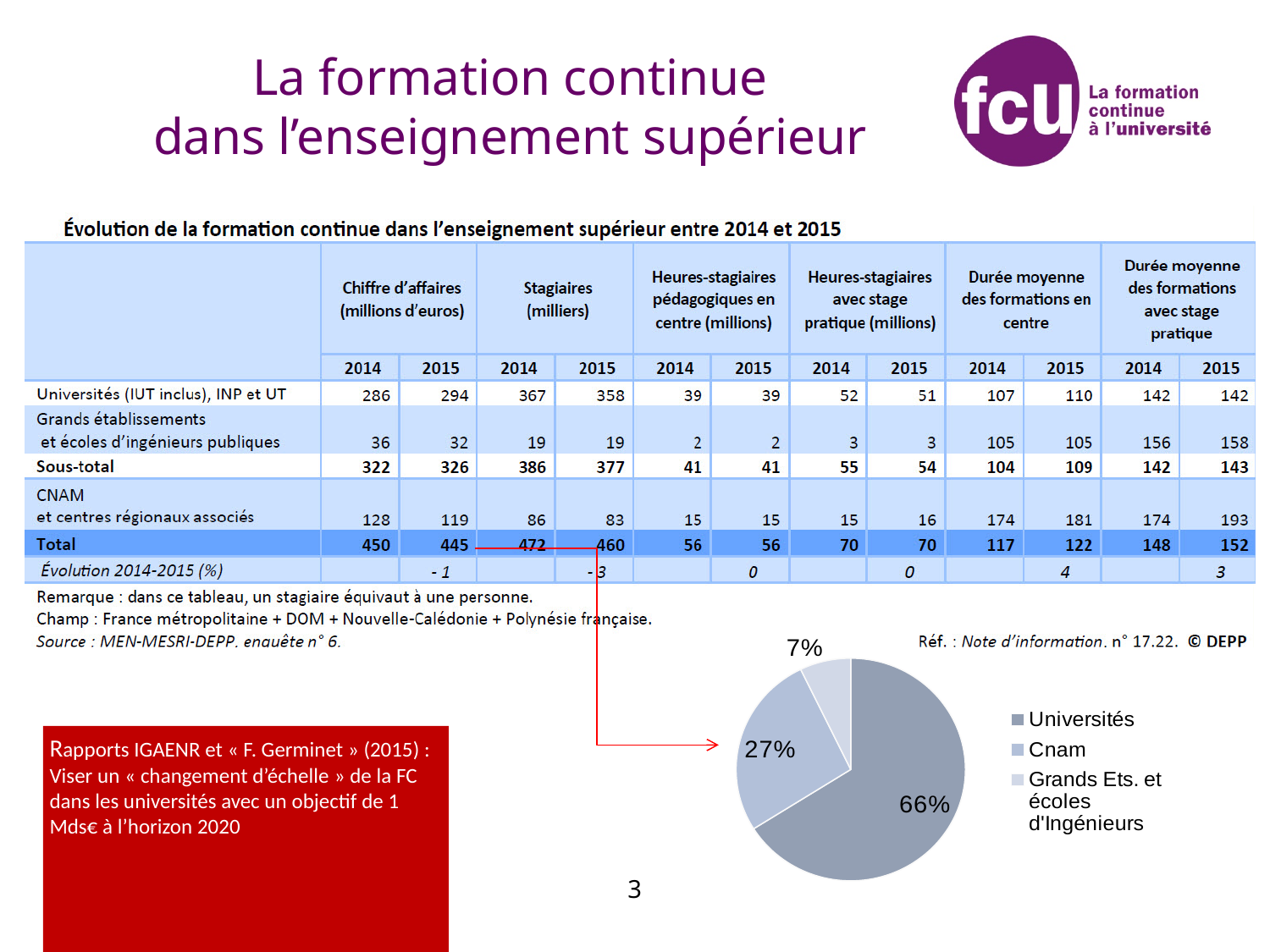
How many entries does the legend of the pie chart list? 3 In the pie chart, what share is shown for Universités? 66% In the pie chart, which is larger: the Cnam slice or the Grands Ets. et écoles d'Ingénieurs slice? Cnam How many slices does the pie chart have? 3 In the pie chart, what share is shown for Grands Ets. et écoles d'Ingénieurs? 7% In the pie chart legend, which entry is listed first? Universités In the pie chart, how many percentage points larger is the Universités slice than the Cnam slice? 39 What kind of chart is shown at the bottom right of the slide? pie chart In the pie chart, what share is shown for Cnam? 27% Which category has the largest slice in the pie chart? Universités Which category has the smallest slice in the pie chart? Grands Ets. et écoles d'Ingénieurs In the pie chart, how many percentage points larger is the Cnam slice than the Grands Ets. et écoles d'Ingénieurs slice? 20